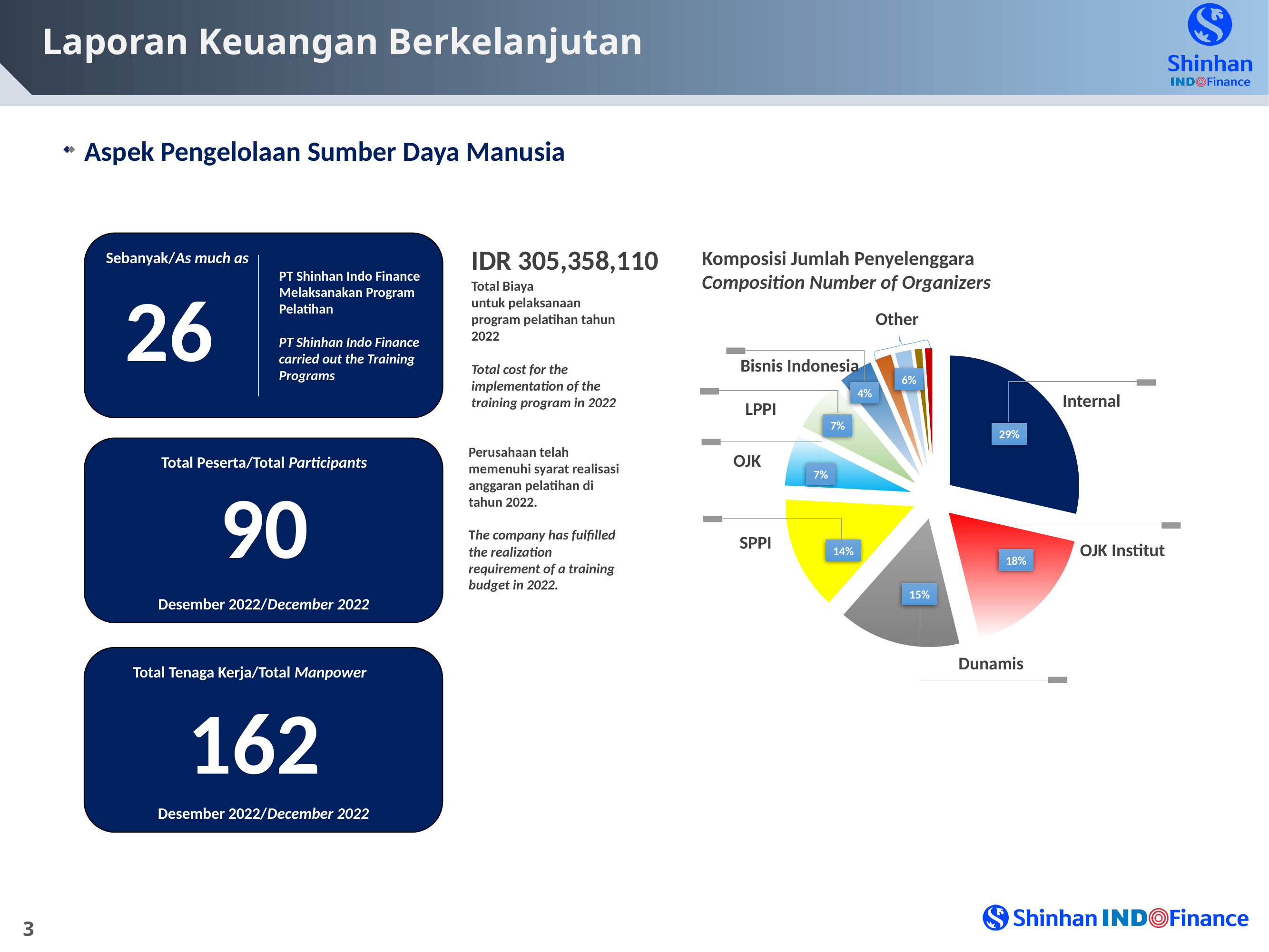
What share of the pie chart does Internal account for? 29% Which organizer has the largest slice of the pie chart? Internal Which has the larger share in the pie chart, Dunamis or SPPI? Dunamis What percentage is shown for OJK Institut in the pie chart? 18% What kind of chart is shown under the title "Komposisi Jumlah Penyelenggara"? pie chart Which labelled organizer has the smallest slice of the pie chart? Bisnis Indonesia What percentage is shown for the Other group in the pie chart? 6% What percentage is shown for SPPI in the pie chart? 14% What is the English title of the pie chart? Composition Number of Organizers What percentage is shown for Dunamis in the pie chart? 15% By how many percentage points does Internal exceed OJK Institut in the pie chart? 11 percentage points What percentage is shown for Bisnis Indonesia in the pie chart? 4%